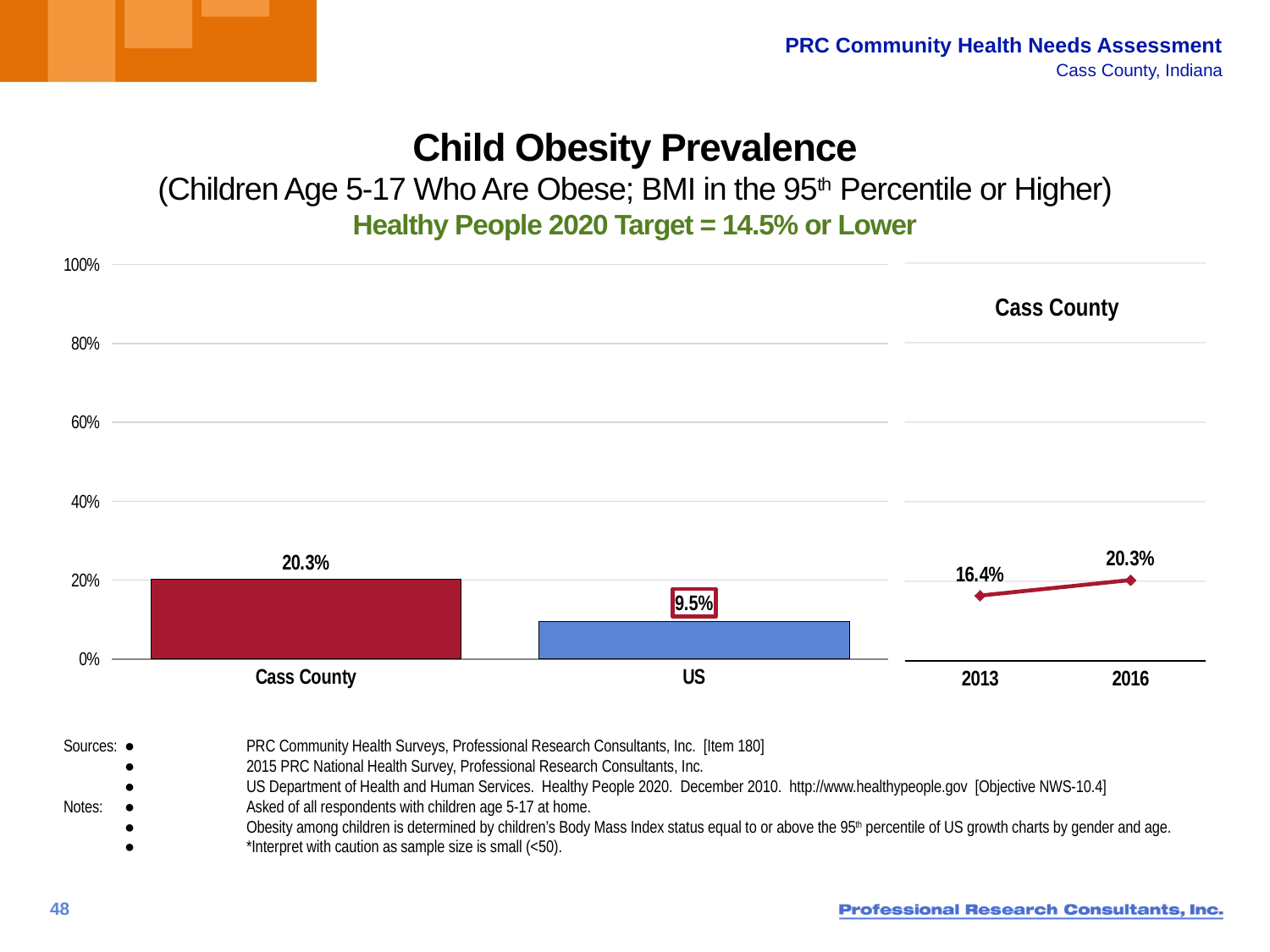
In the bar chart on the left, which category has the lowest value? US In the bar chart on the left, how many categories are shown? 2 In the Cass County trend chart on the right, what is the value for 2016? 20.3% In the bar chart on the left, what is the value for Cass County? 20.3% In the Cass County trend chart on the right, what is the value for 2013? 16.4% What is the Healthy People 2020 target stated in the chart title? 14.5% or Lower In the bar chart on the left, what is the value for US? 9.5% In the bar chart on the left, which category has the higher value? Cass County In the bar chart on the left, what is the difference between the Cass County value and the US value? 10.8% In the Cass County trend chart on the right, what is the difference between the 2016 and 2013 values? 3.9% In the Cass County trend chart on the right, do values rise or fall from 2013 to 2016? Rise What kind of chart is the chart on the left? Bar chart